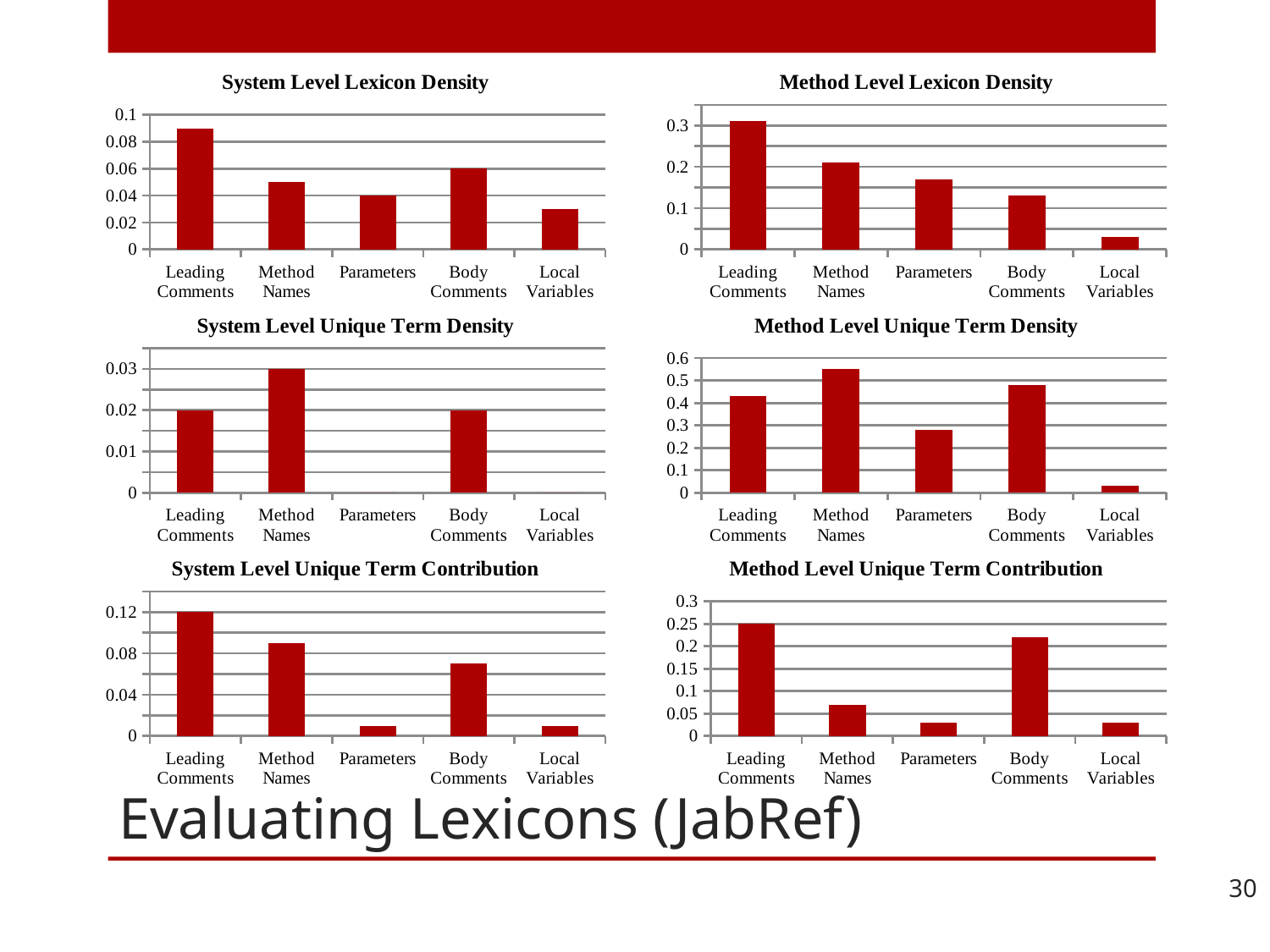
In the System Level Unique Term Contribution chart, which is larger, the value for Method Names or the value for Body Comments? Method Names What kind of chart is the Method Level Unique Term Density chart? bar chart In the System Level Unique Term Density chart, what is the value for Method Names? 0.03 In the Method Level Unique Term Contribution chart, is the value for Method Names greater or less than 0.1? less In the Method Level Lexicon Density chart, which category has the lowest value? Local Variables In the Method Level Lexicon Density chart, do the values rise or fall from Leading Comments to Local Variables? fall In the System Level Lexicon Density chart, which category has the highest value? Leading Comments In the System Level Unique Term Contribution chart, what is the value for Leading Comments? 0.12 In the Method Level Unique Term Density chart, which category has the highest value? Method Names How many categories are shown on the x axis of the System Level Lexicon Density chart? 5 In the Method Level Unique Term Contribution chart, what is the value for Leading Comments? 0.25